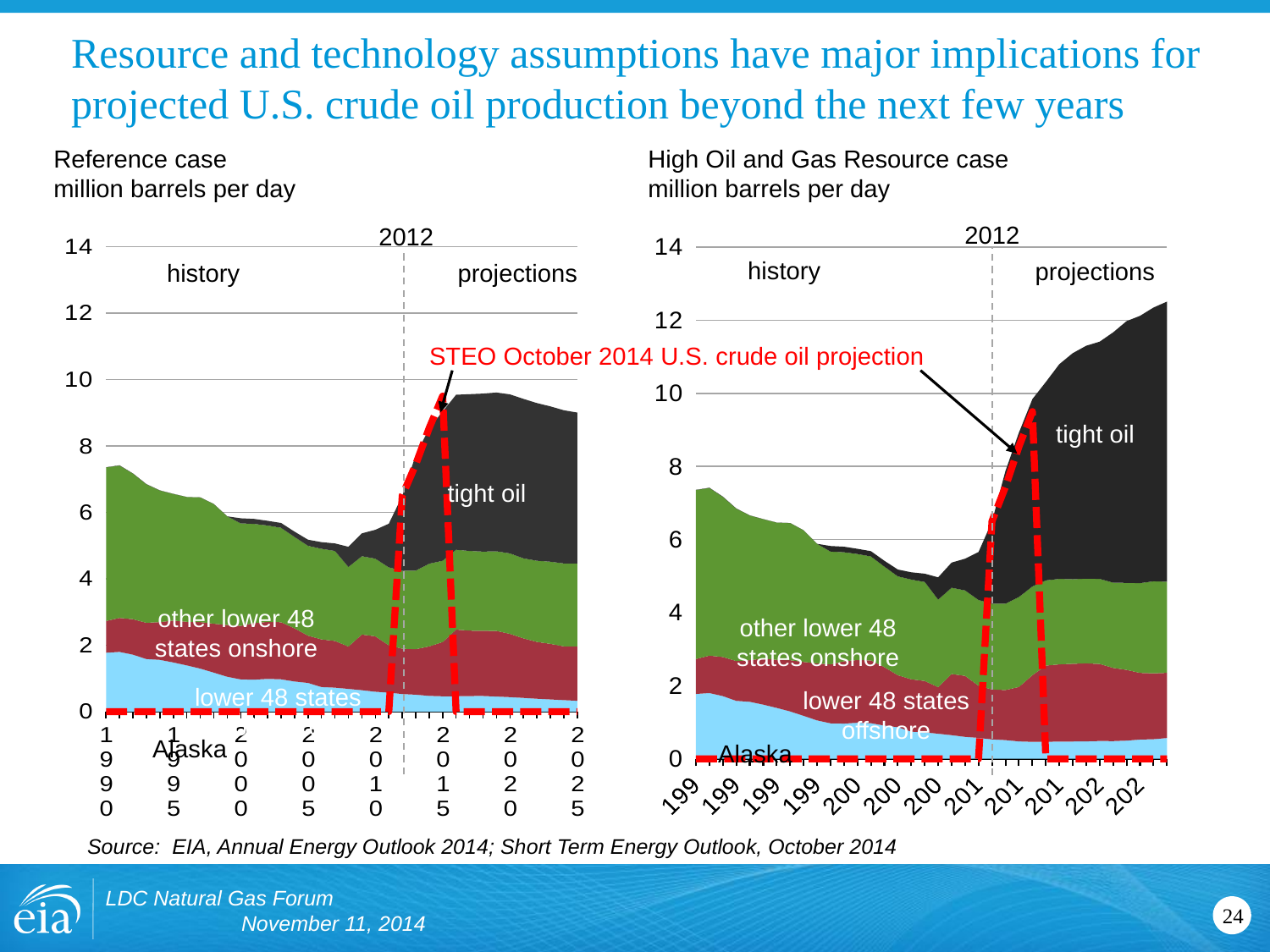
In the Reference case chart, is the total crude oil production in 2025 greater or less than 10? less In the Reference case chart, is the total crude oil production in 2025 greater or less than 8? greater In the High Oil and Gas Resource case chart, is the total crude oil production in 2025 greater or less than 12? greater In the High Oil and Gas Resource case chart, which category is the largest contributor to production in 2025? tight oil In the Reference case chart, what year does the dashed vertical line separating history from projections mark? 2012 In the Reference case chart, does total crude oil production rise or fall between 1990 and 2005? fall Which chart shows the higher total crude oil production in 2025, the Reference case or the High Oil and Gas Resource case? High Oil and Gas Resource case What unit is used on the y axis of both charts? million barrels per day What kind of chart is the Reference case chart? stacked area chart How many production categories are labeled as areas in the High Oil and Gas Resource case chart? 4 In the High Oil and Gas Resource case chart, does total crude oil production rise or fall between 2012 and 2025? rise